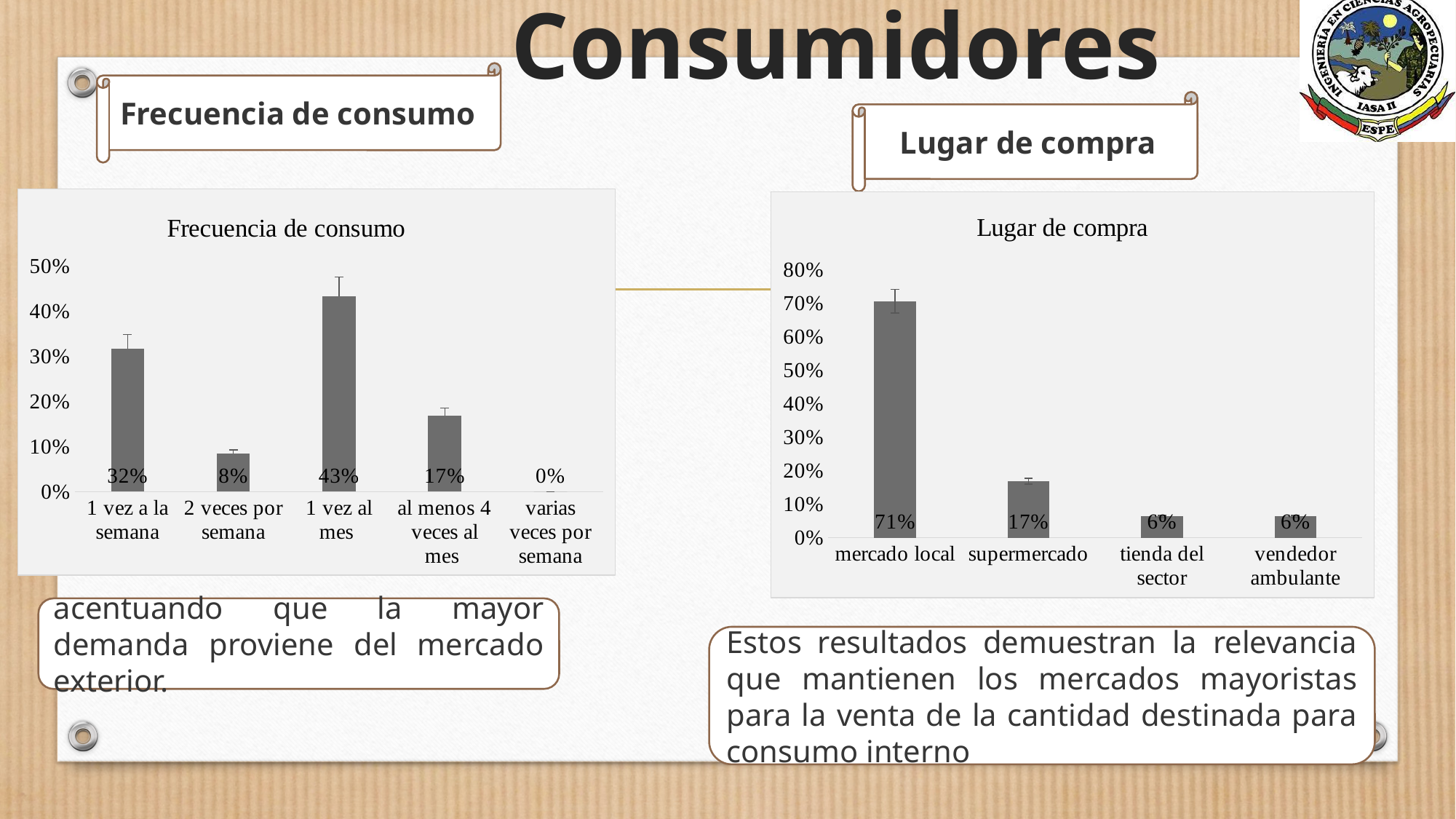
In the 'Frecuencia de consumo' chart, how many categories are shown on the x axis? 5 In the 'Frecuencia de consumo' chart, what is the difference between '1 vez a la semana' and 'al menos 4 veces al mes'? 15% In the 'Frecuencia de consumo' chart, which category has the lowest value? varias veces por semana In the 'Frecuencia de consumo' chart, what is the value for '2 veces por semana'? 8% In the 'Lugar de compra' chart, which category has the highest value? mercado local In the 'Lugar de compra' chart, is the value for 'mercado local' greater or less than 60%? greater In the 'Frecuencia de consumo' chart, what is the value for '1 vez al mes'? 43% In the 'Frecuencia de consumo' chart, which category has the highest value? 1 vez al mes In the 'Lugar de compra' chart, what is the difference between 'mercado local' and 'supermercado'? 54% In the 'Lugar de compra' chart, what is the value for 'mercado local'? 71% What kind of chart is the 'Lugar de compra' chart? bar chart In the 'Lugar de compra' chart, what is the value for 'supermercado'? 17%